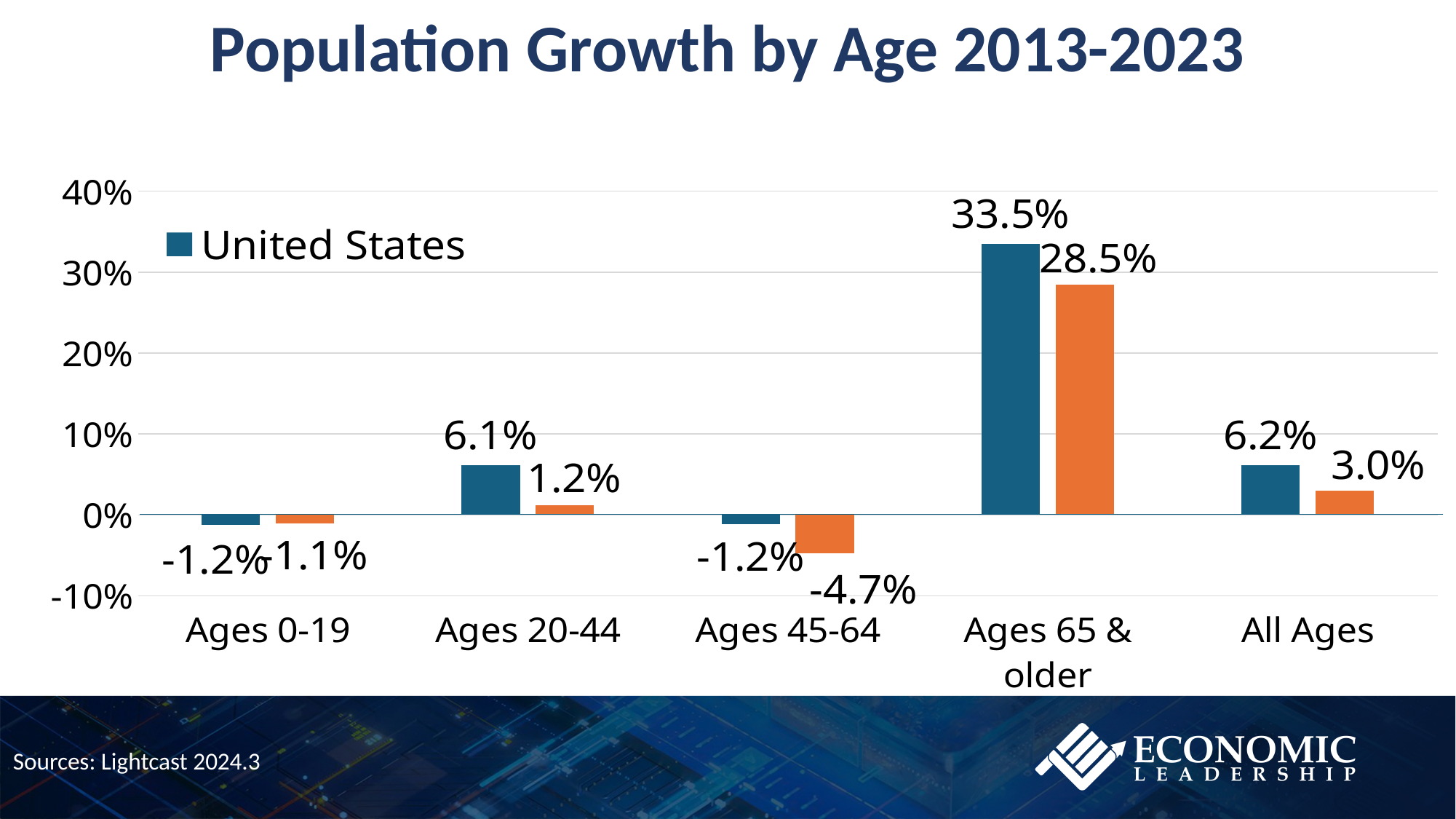
Is the United States value for Ages 65 & older greater or less than 30%? greater How many series does the legend list? 1 What kind of chart is shown on the slide? bar chart Which is larger for the United States: Ages 20-44 or Ages 65 & older? Ages 65 & older Which age category has the highest United States value? Ages 65 & older What is the United States value for All Ages? 6.2% What is the United States value for Ages 20-44? 6.1% What is the title of the chart? Population Growth by Age 2013-2023 How many age categories are shown on the x axis? 5 What is the United States value for Ages 0-19? -1.2% What is the difference between the United States values for Ages 65 & older and Ages 20-44? 27.4% What is the United States value for Ages 65 & older? 33.5%